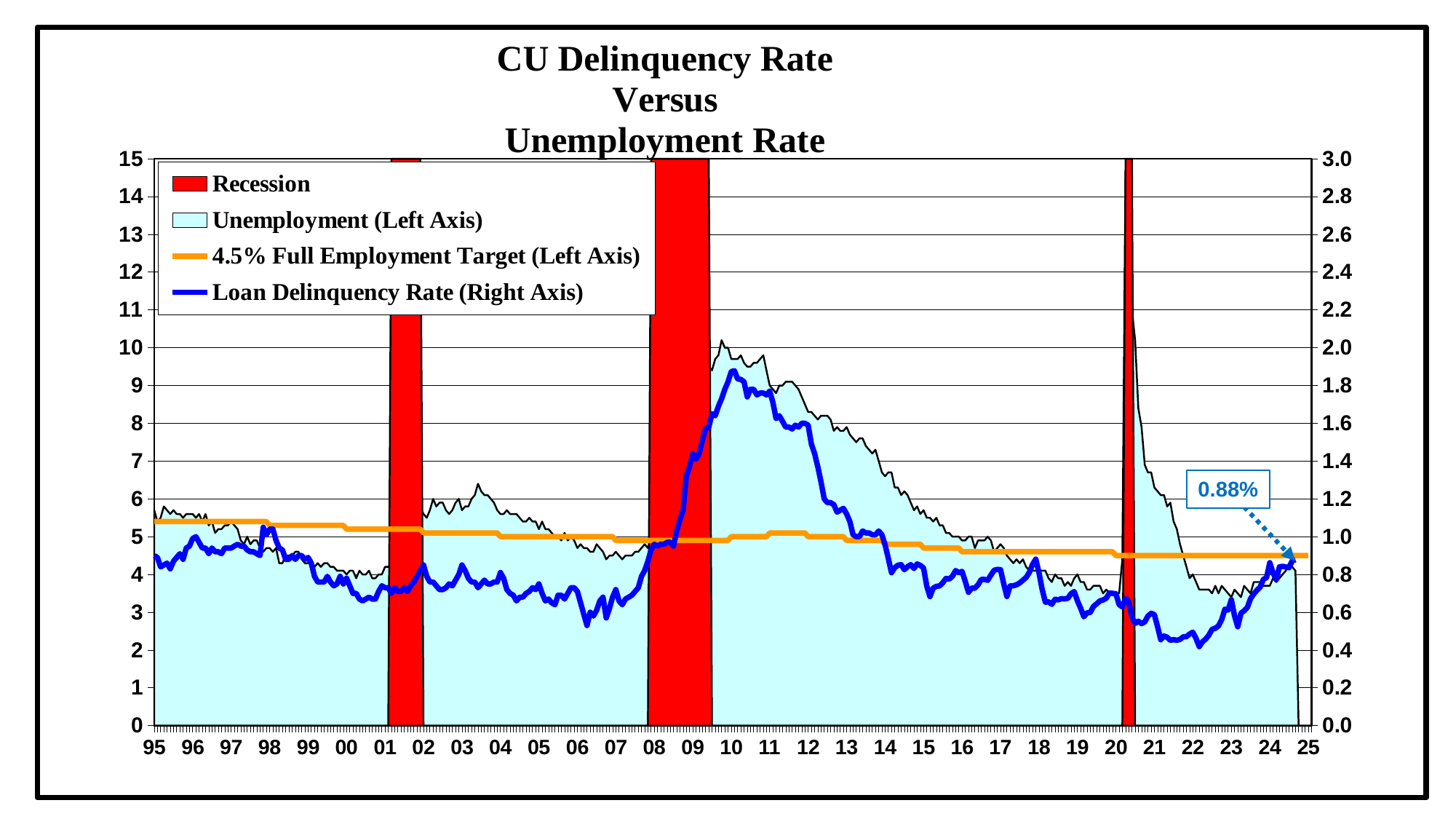
What is the title of the chart? CU Delinquency Rate Versus Unemployment Rate How many recession periods are shaded on the chart? 3 In which year does the Unemployment series reach its highest peak? 2020 Is the Loan Delinquency Rate at its 2010 peak greater or less than 1.6? greater Does the Loan Delinquency Rate rise or fall between 2021 and 2024? rise How many entries does the legend list? 4 Which axis is the Loan Delinquency Rate plotted against? Right axis Is the Unemployment value at its 2020 peak greater or less than 10? greater What is the latest Loan Delinquency Rate value labelled on the chart? 0.88% Is the Loan Delinquency Rate at its 2010 peak higher or lower than at its 2022 low? higher Does the Unemployment series rise or fall between 2010 and 2019? fall